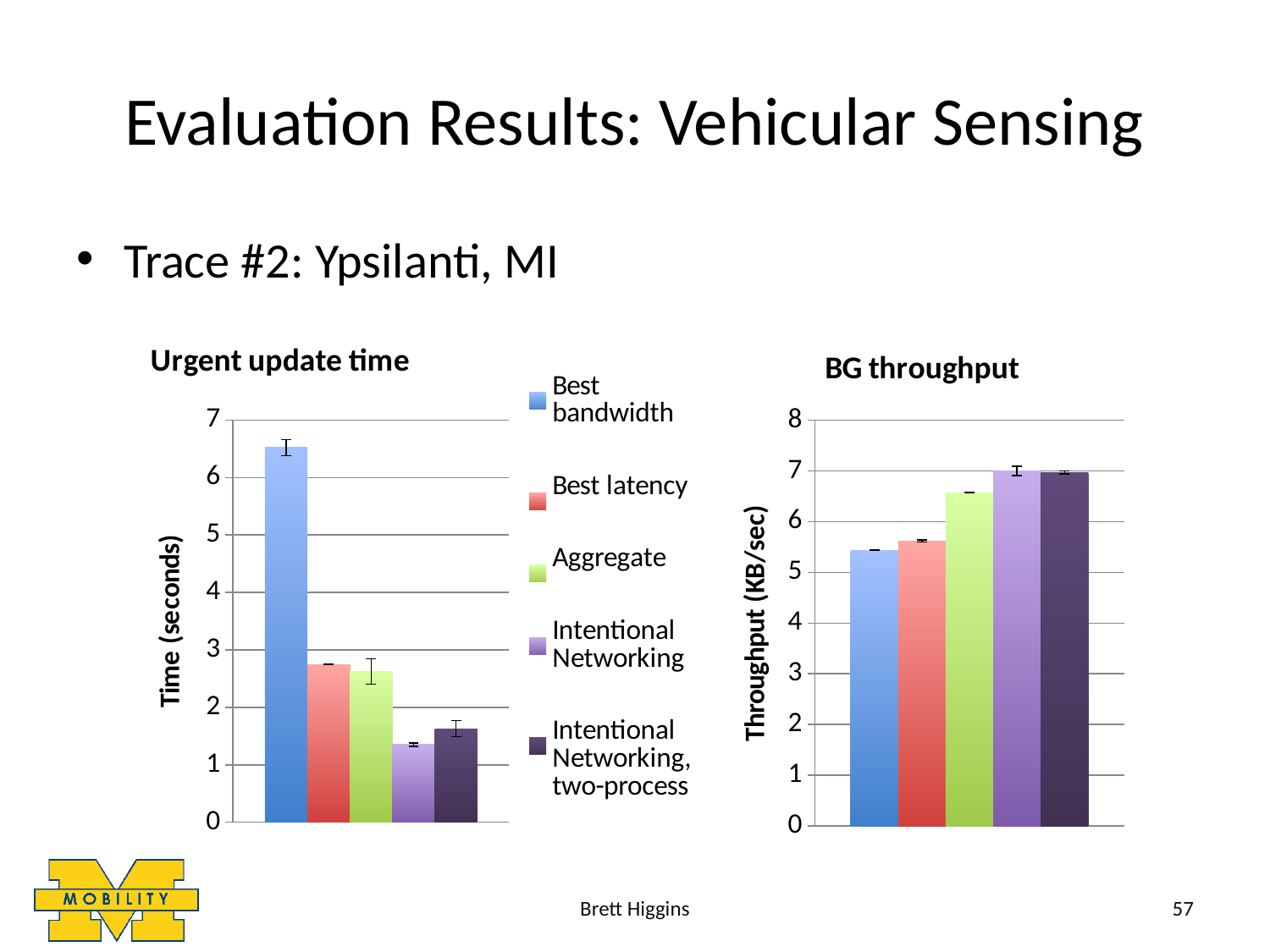
How many series does the legend list for the charts on this slide? 5 What kind of chart is the "Urgent update time" chart? bar chart In the "BG throughput" chart, is the value for Best bandwidth greater or less than 6? less In the "BG throughput" chart, which is larger: the value for Best bandwidth or the value for Aggregate? Aggregate In the "Urgent update time" chart, which series has the lowest value? Intentional Networking In the "BG throughput" chart, is the value for Aggregate greater or less than 6? greater In the "Urgent update time" chart, is the value for Best latency greater or less than 3? less How many bars are plotted in the "BG throughput" chart? 5 In the "Urgent update time" chart, which series has the highest value? Best bandwidth What is the y-axis label of the "BG throughput" chart? Throughput (KB/sec) In the "Urgent update time" chart, which is larger: the value for Best bandwidth or the value for Best latency? Best bandwidth